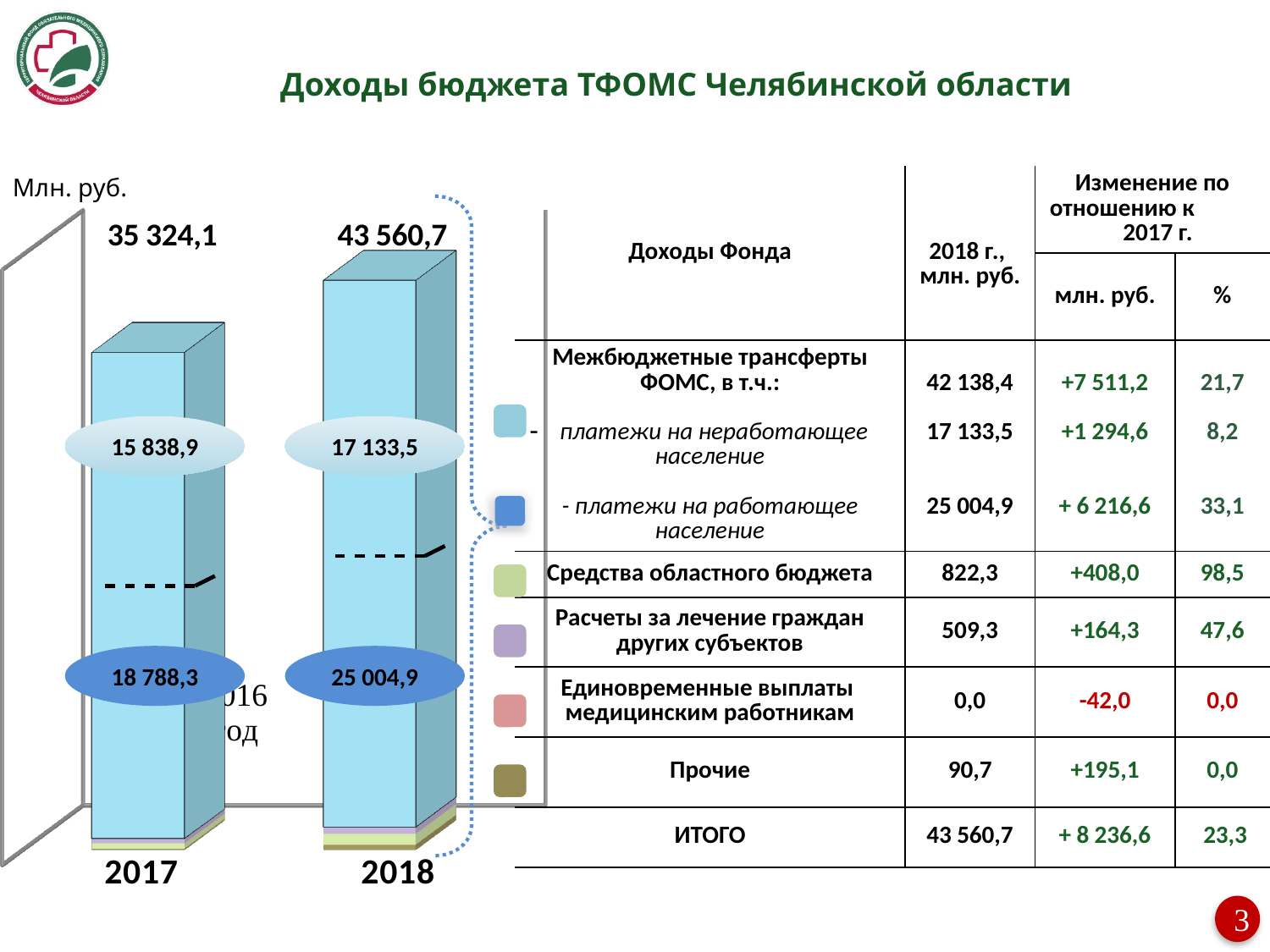
Do the total bar values rise or fall from 2017 to 2018? Rise How many years (bars) are shown in the chart? 2 What unit of measurement is indicated at the top left of the chart? Млн. руб. What value is shown in the upper (light blue) oval label on the 2017 bar? 15 838,9 What value is shown in the lower (dark blue) oval label on the 2017 bar? 18 788,3 Which year has the higher total bar value, 2017 or 2018? 2018 By how much does the lower (dark blue) segment value for 2018 exceed that for 2017? 6 216,6 What kind of chart is shown on the left of the slide? Stacked bar chart What value is shown in the lower (dark blue) oval label on the 2018 bar? 25 004,9 What is the total value shown above the bar for 2018? 43 560,7 What is the total value shown above the bar for 2017? 35 324,1 What is the difference between the total bar values for 2018 and 2017? 8 236,6